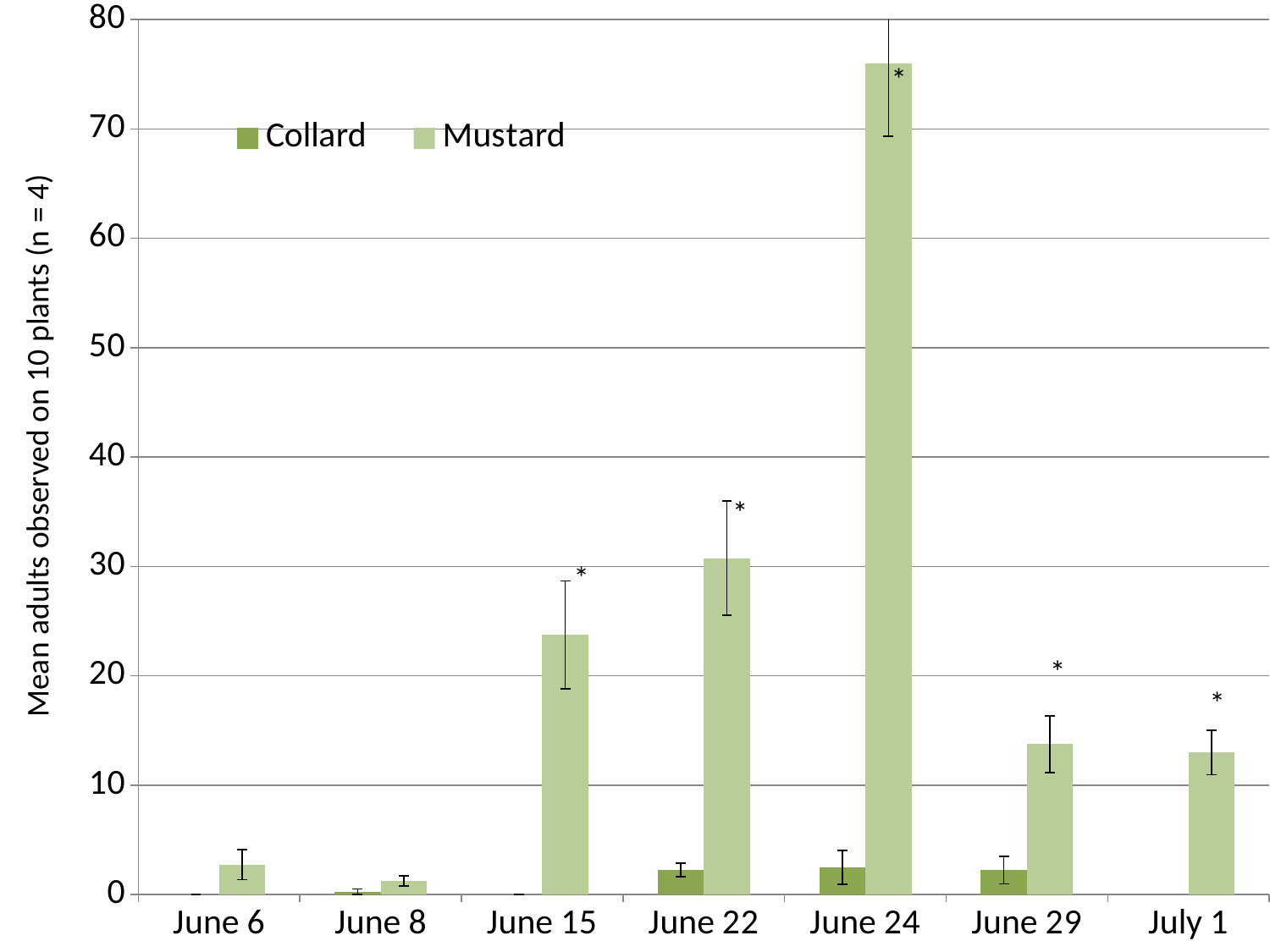
What kind of chart is shown on the slide? bar chart Is the Mustard value for June 24 greater or less than 70? greater On which date is the Mustard value lowest? June 8 What is the label on the vertical axis? Mean adults observed on 10 plants (n = 4) On June 24, which series has the larger value, Collard or Mustard? Mustard How many series does the legend list? 2 Is the Mustard value for July 1 greater or less than 10? greater Which is larger, the Mustard value for June 15 or the Mustard value for June 22? June 22 Is the Mustard value for June 15 greater or less than 20? greater On which date is the Mustard value highest? June 24 How many dates are shown along the x axis? 7